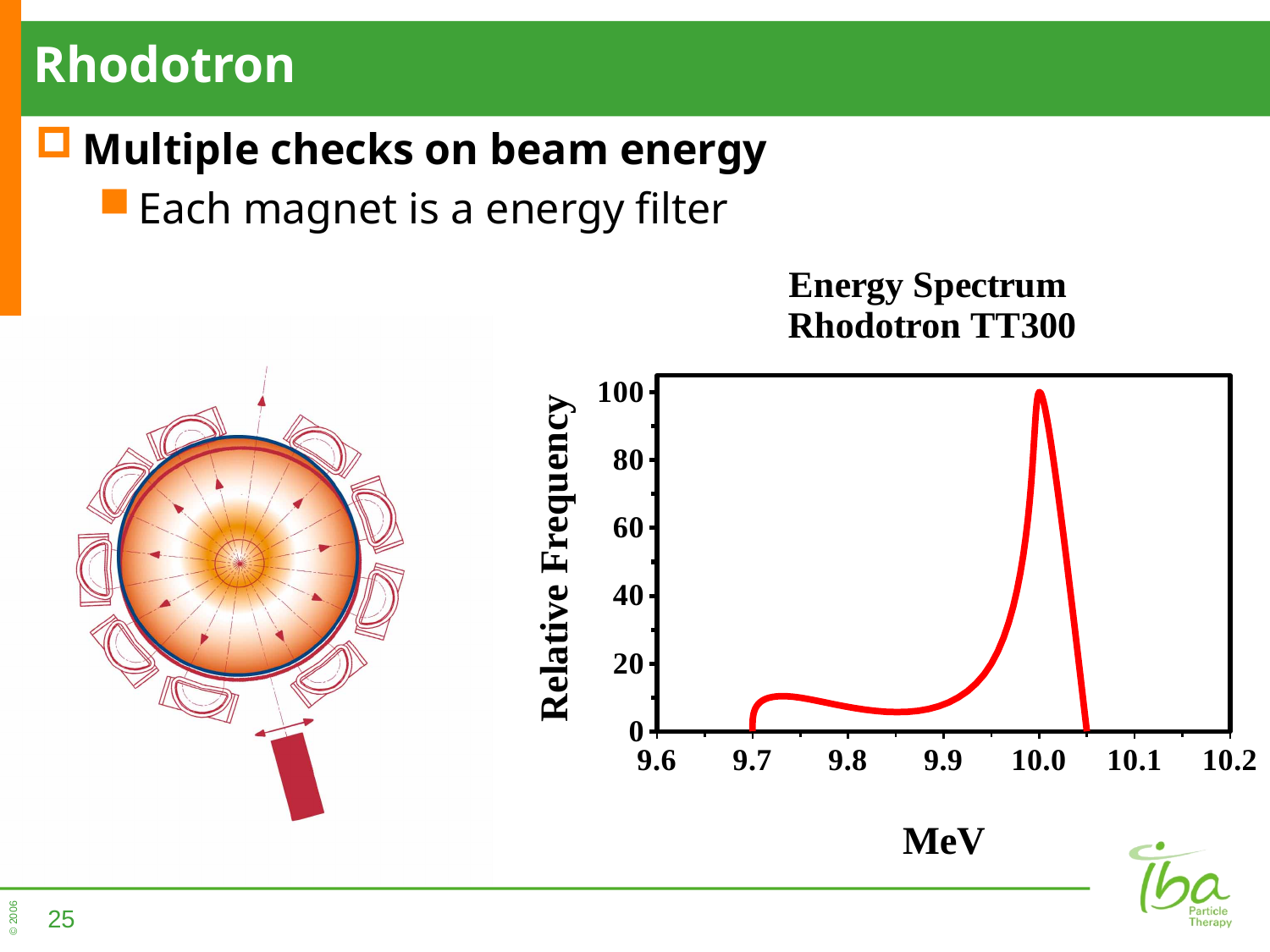
How many curves are plotted on the Energy Spectrum chart? 1 Is the relative frequency at 9.9 MeV greater or less than 40? less Which has the higher relative frequency on the Energy Spectrum chart: 9.7 MeV or 10.0 MeV? 10.0 MeV At which energy on the x axis does the Energy Spectrum curve reach its highest relative frequency? 10.0 What kind of chart is shown under the title "Energy Spectrum Rhodotron TT300"? line chart How many labelled tick values are shown on the x axis of the Energy Spectrum chart? 7 What is the peak relative frequency value reached by the Energy Spectrum curve? 100 What is the title of the chart on the slide? Energy Spectrum Rhodotron TT300 What is the label of the y axis of the Energy Spectrum chart? Relative Frequency Does the relative frequency rise or fall as the energy increases from 9.9 MeV to 10.0 MeV? rise Is the relative frequency at 10.0 MeV greater or less than 80? greater Is the relative frequency at 9.8 MeV greater or less than 20? less